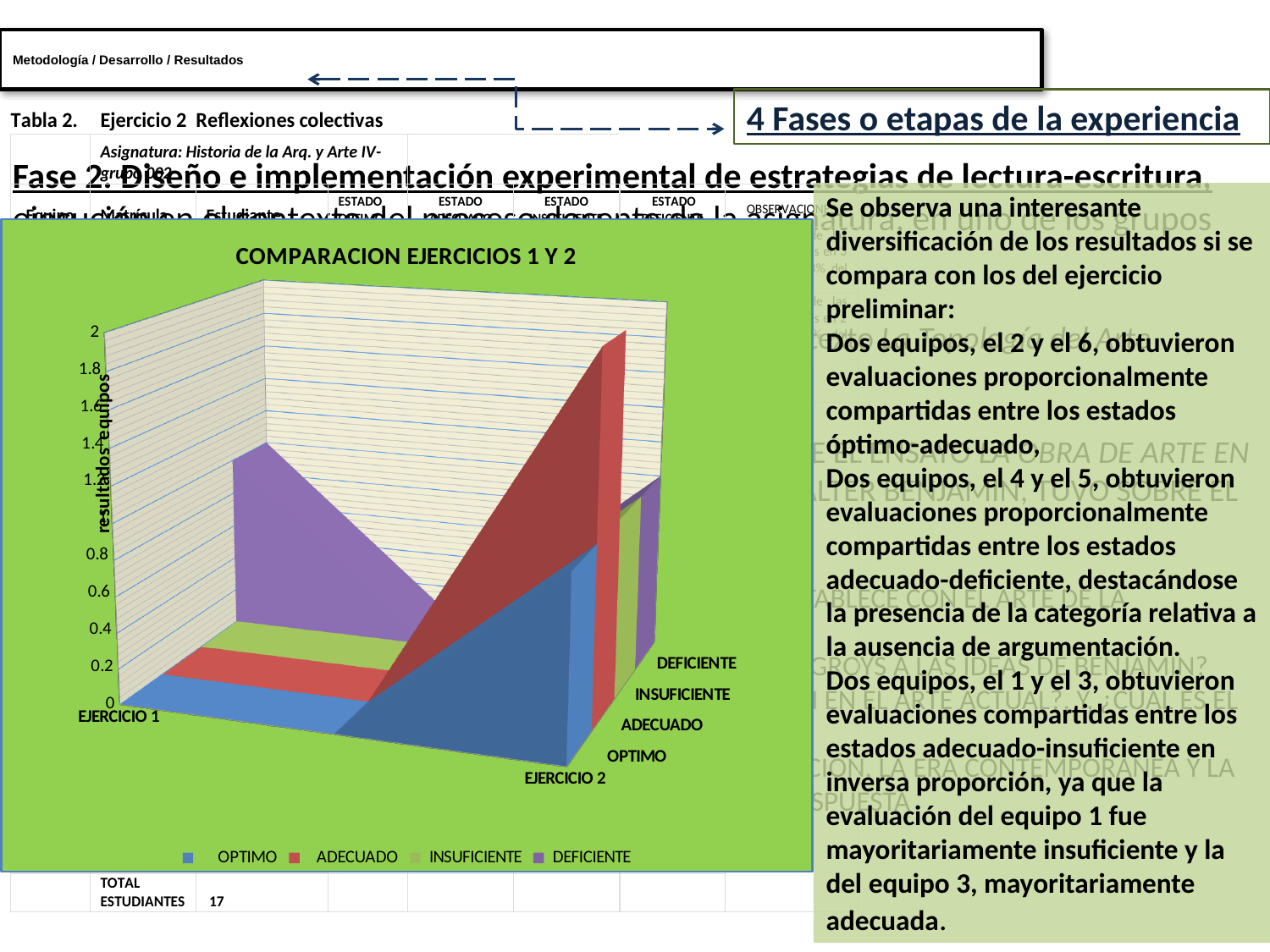
What is the title of the chart on the slide? COMPARACION EJERCICIOS 1 Y 2 Which series are listed in the chart legend? OPTIMO, ADECUADO, INSUFICIENTE, DEFICIENTE What is the label of the vertical axis of the chart? resultados equipos What are the two categories on the x axis of the chart? EJERCICIO 1 and EJERCICIO 2 How many categories are shown along the x axis of the chart? 2 Is the ADECUADO value for EJERCICIO 2 greater or less than 1? greater Does the ADECUADO series rise or fall from EJERCICIO 1 to EJERCICIO 2? rise What kind of chart is shown on the slide? 3D area chart Is the DEFICIENTE value for EJERCICIO 1 greater or less than 0.6? greater How many series does the chart legend list? 4